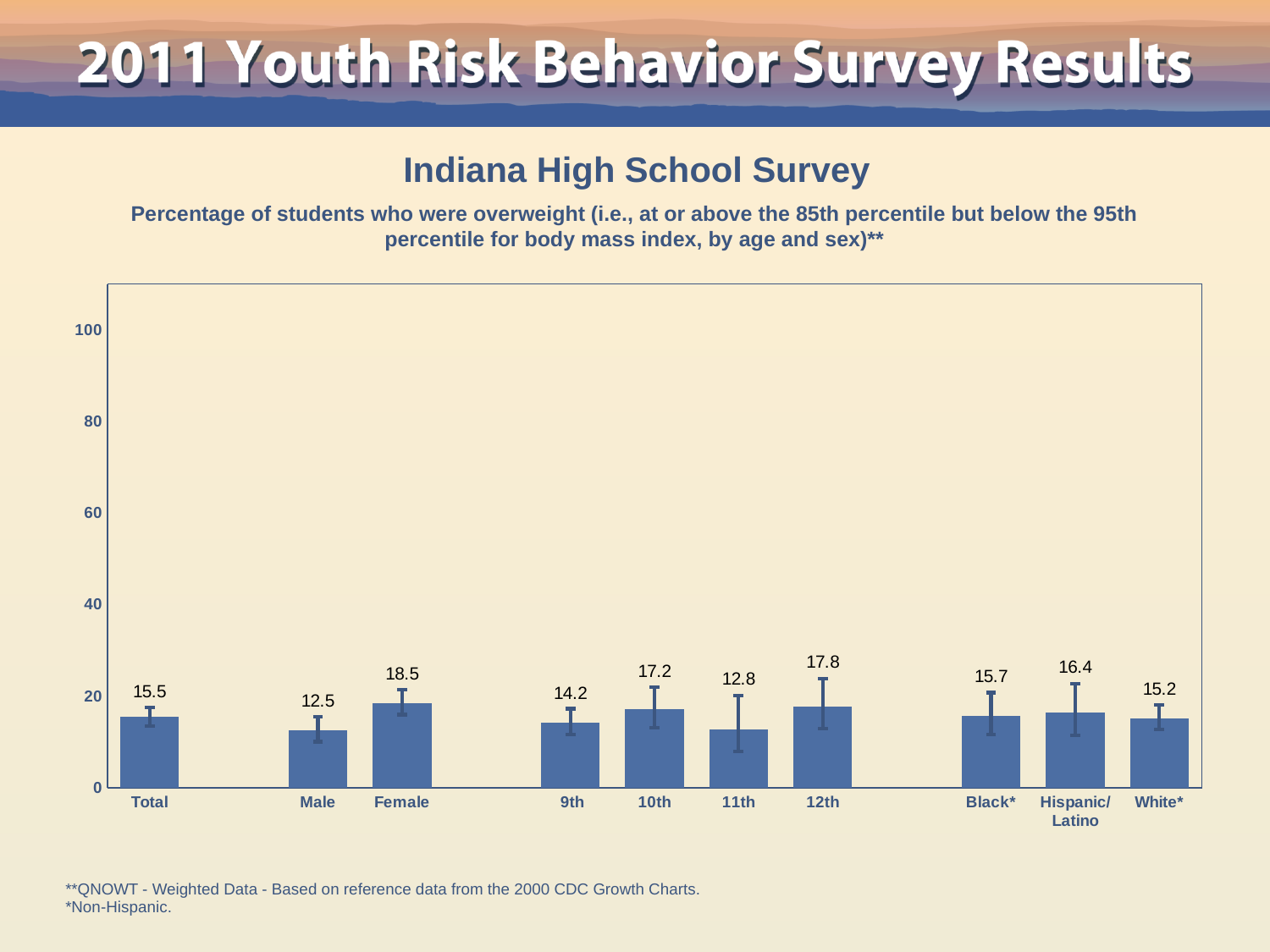
What is the difference between the values for Female and Male? 6.0 What is the value for 11th? 12.8 Which is larger, the value for Black* or the value for White*? Black* What is the value for Female? 18.5 Is the value for 10th greater or less than 20? less What kind of chart is this? bar chart What is the value for Total? 15.5 How many categories are shown on the x axis? 10 What is the difference between the values for 12th and 9th? 3.6 Which category has the highest value? Female What is the value for Hispanic/Latino? 16.4 Which category has the lowest value? Male